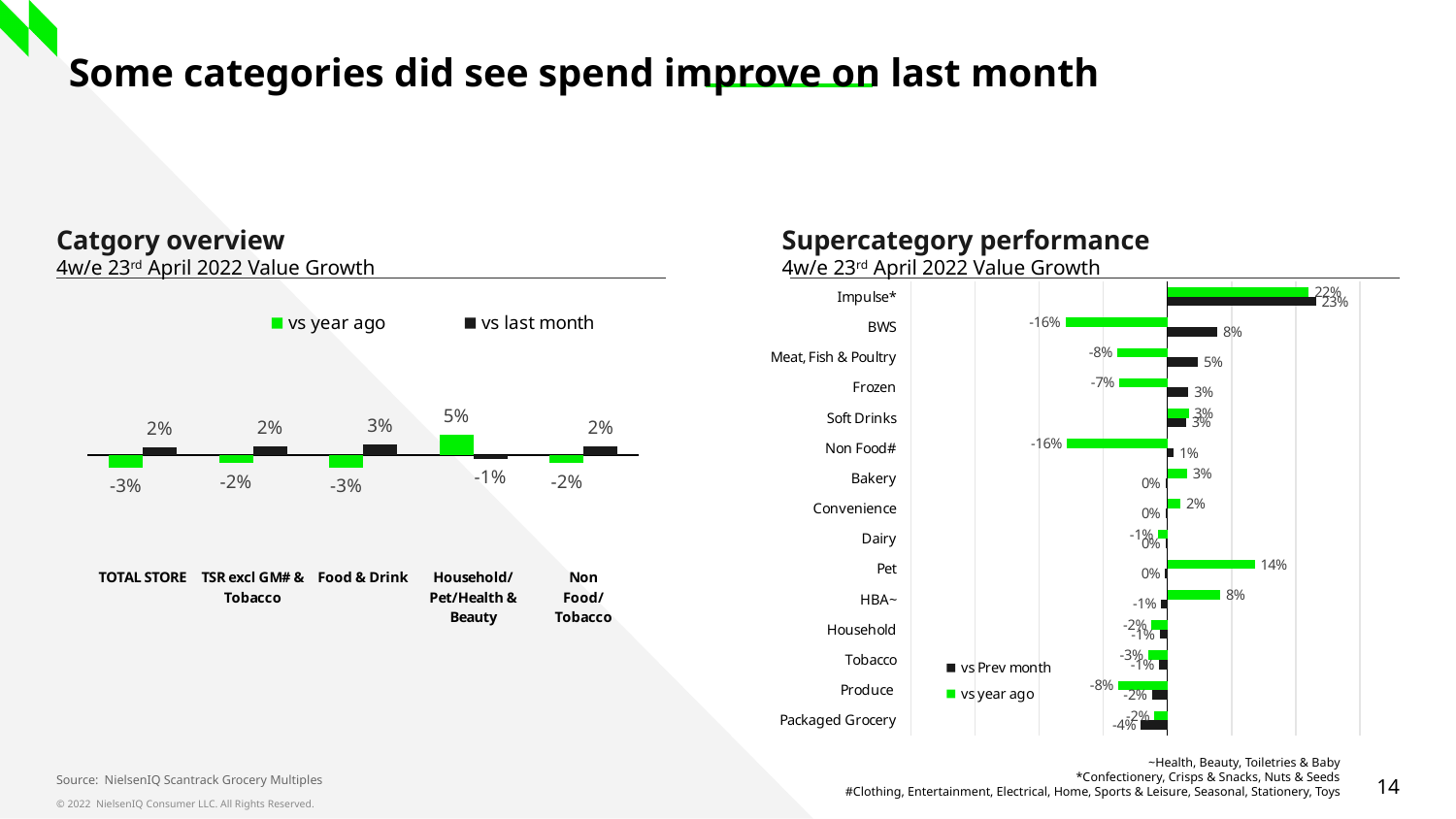
In the Catgory overview chart, what is the vs year ago value for TOTAL STORE? -3% In the Supercategory performance chart, which supercategory has the highest vs year ago value? Impulse* In the Supercategory performance chart, how many supercategories are plotted? 15 In the Supercategory performance chart, which supercategory has the lowest vs Prev month value? Packaged Grocery In the Supercategory performance chart, what is the vs year ago value for BWS? -16% In the Supercategory performance chart, what is the vs Prev month value for Impulse*? 23% In the Catgory overview chart, what is the difference between the vs year ago and vs last month values for Household/Pet/Health & Beauty? 6 percentage points In the Supercategory performance chart, which is larger: the vs year ago value for Pet or for HBA~? Pet In the Catgory overview chart, which category has the highest vs year ago value? Household/Pet/Health & Beauty In the Catgory overview chart, what is the vs last month value for Food & Drink? 3% What type of chart is the Supercategory performance chart? Bar chart In the Catgory overview chart, how many series does the legend list? 2